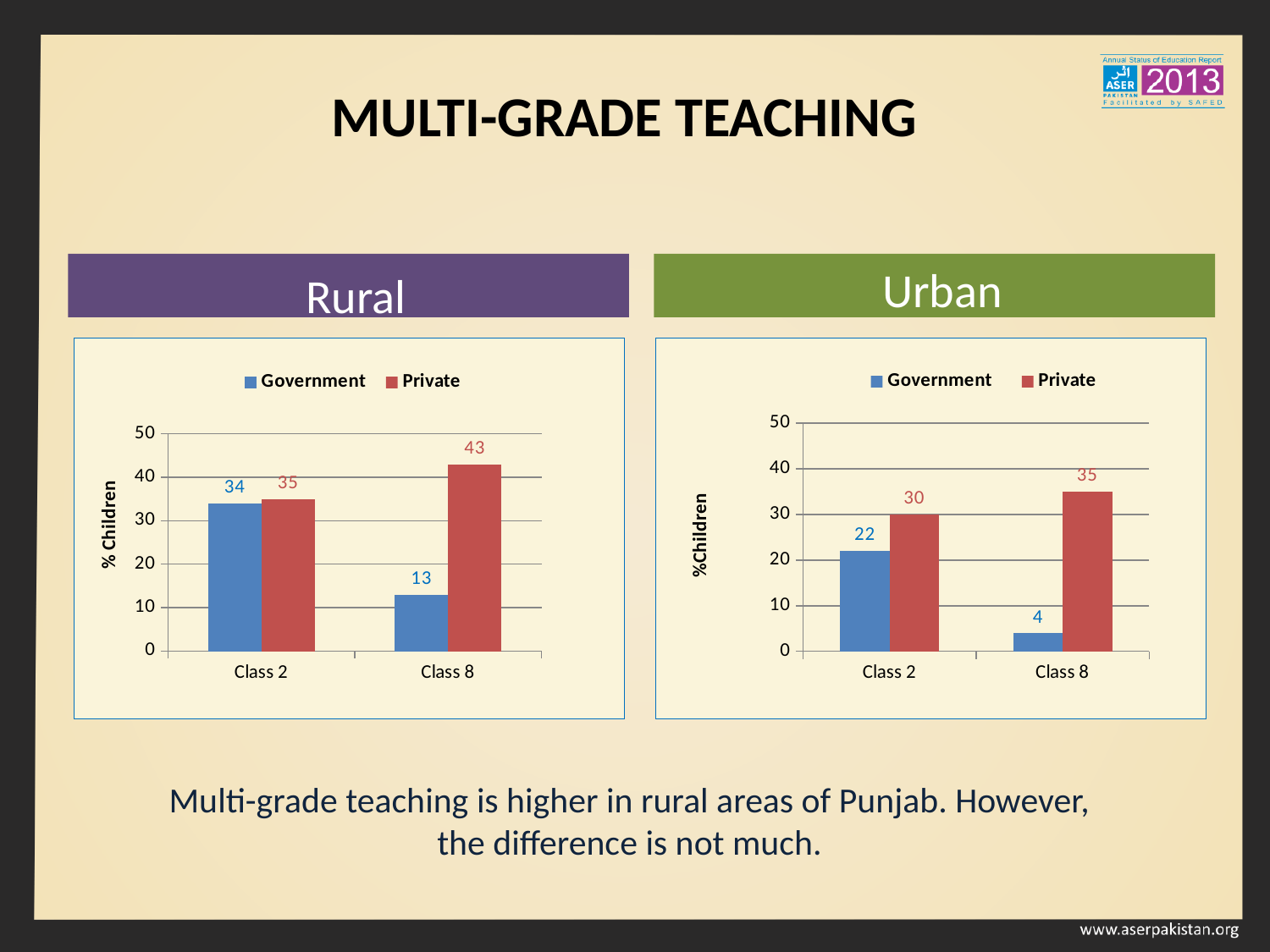
In the Rural chart, what is the value for Government in Class 2? 34 In the Rural chart, what is the value for Private in Class 8? 43 In the Rural chart, what is the difference between Private and Government in Class 8? 30 In the Urban chart, what is the difference between Private and Government in Class 2? 8 In the Urban chart, which bar has the lowest value? Government, Class 8 In the Rural chart, does the Government value rise or fall from Class 2 to Class 8? Fall What kind of chart is the Urban chart? Bar chart In the Urban chart, which is larger in Class 8: Government or Private? Private In the Urban chart, what is the value for Private in Class 2? 30 In the Rural chart, which bar has the highest value? Private, Class 8 How many series does the legend of the Rural chart list? 2 In the Urban chart, what is the value for Government in Class 8? 4